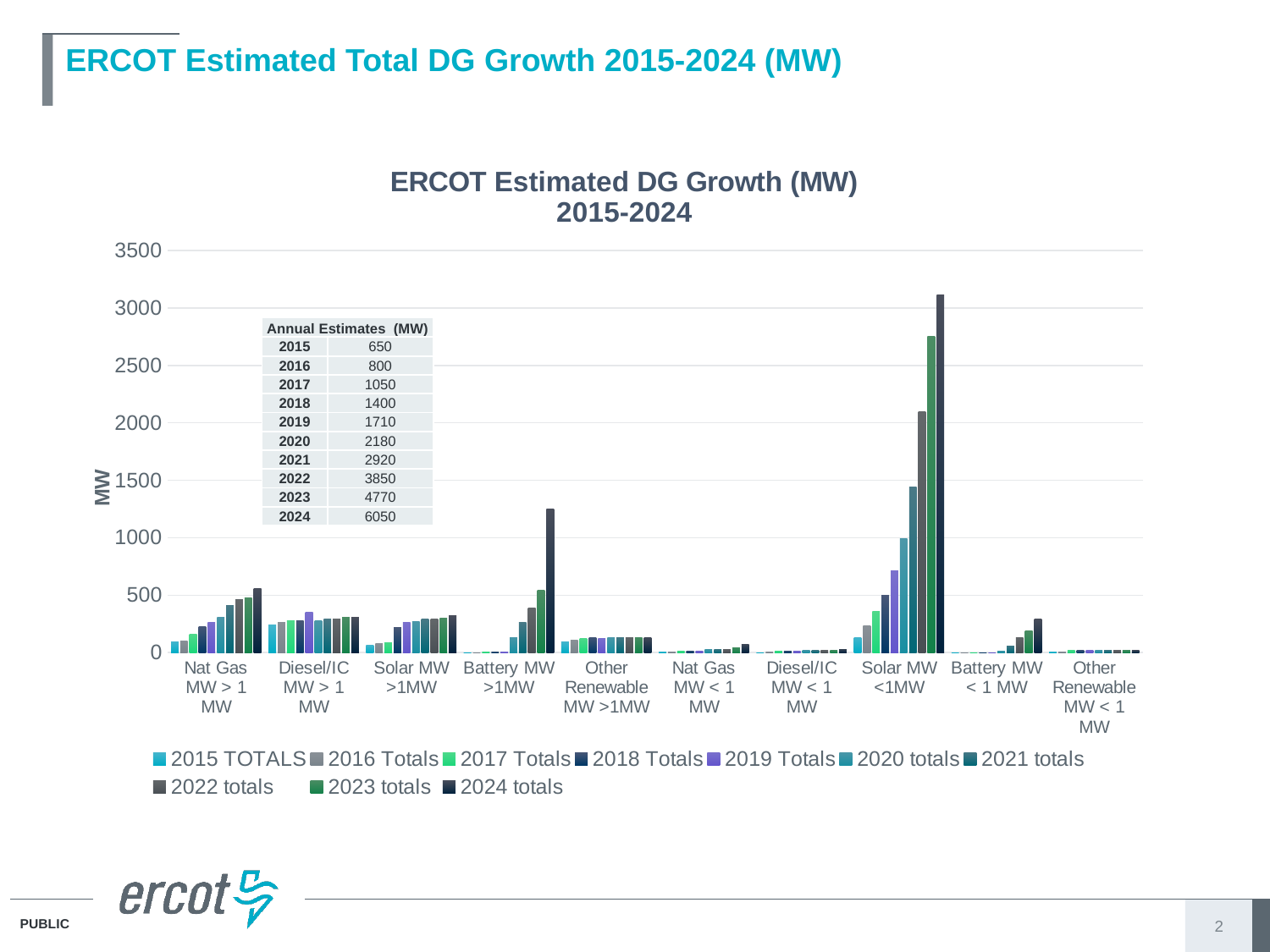
Is the 2024 totals value for Solar MW <1MW greater or less than 3000? greater How many categories are shown along the x axis of the chart? 10 Is the 2024 totals value for Battery MW >1MW greater or less than 1000? greater Which category has the tallest bar in the chart? Solar MW <1MW What is the title of the chart? ERCOT Estimated DG Growth (MW) 2015-2024 How many series does the chart legend list? 10 What kind of chart is shown on the slide? bar chart Is the 2023 totals value for Solar MW <1MW greater or less than 2500? greater Which is larger for the 2024 totals series: Battery MW >1MW or Nat Gas MW > 1 MW? Battery MW >1MW Within the Solar MW <1MW category, which series has the highest bar? 2024 totals Do the bars for Solar MW <1MW rise or fall from the 2015 series to the 2024 series? rise